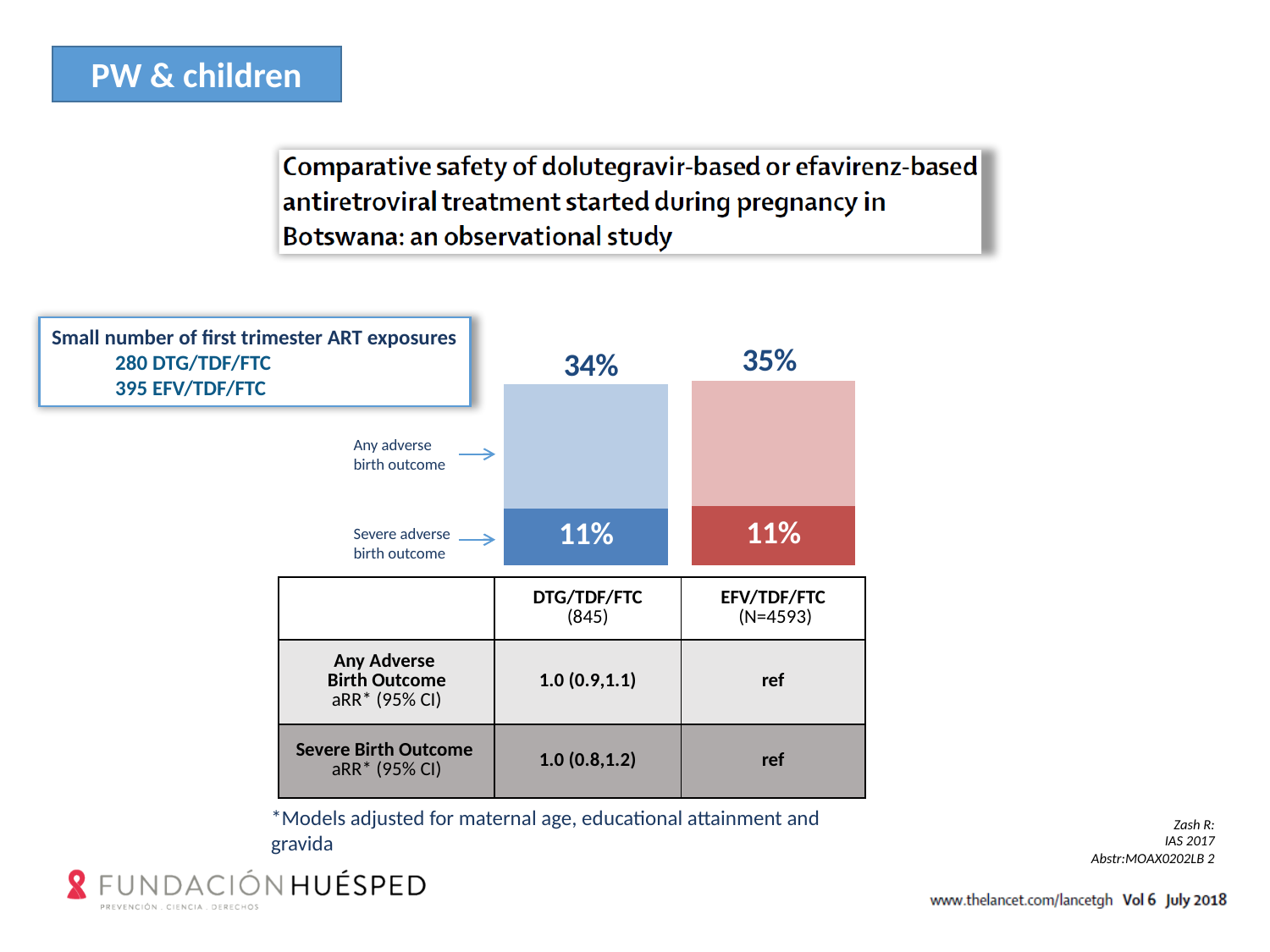
Which treatment group has the higher percentage of any adverse birth outcome, DTG/TDF/FTC or EFV/TDF/FTC? EFV/TDF/FTC What is the percentage of severe adverse birth outcome for EFV/TDF/FTC? 11% Is the percentage of severe adverse birth outcome the same for DTG/TDF/FTC and EFV/TDF/FTC? Yes, both 11% What kind of chart is used to show the adverse birth outcome percentages? Bar chart How many treatment groups are shown as bars in the chart? 2 What is the difference in percentage points between the any adverse birth outcome values for EFV/TDF/FTC and DTG/TDF/FTC? 1 percentage point What colour is the bar for the EFV/TDF/FTC group? Red What colour is the bar for the DTG/TDF/FTC group? Blue What is the difference in percentage points between any adverse birth outcome and severe adverse birth outcome for DTG/TDF/FTC? 23 percentage points What is the percentage of severe adverse birth outcome for DTG/TDF/FTC? 11% What is the percentage of any adverse birth outcome for EFV/TDF/FTC? 35% What is the percentage of any adverse birth outcome for DTG/TDF/FTC? 34%